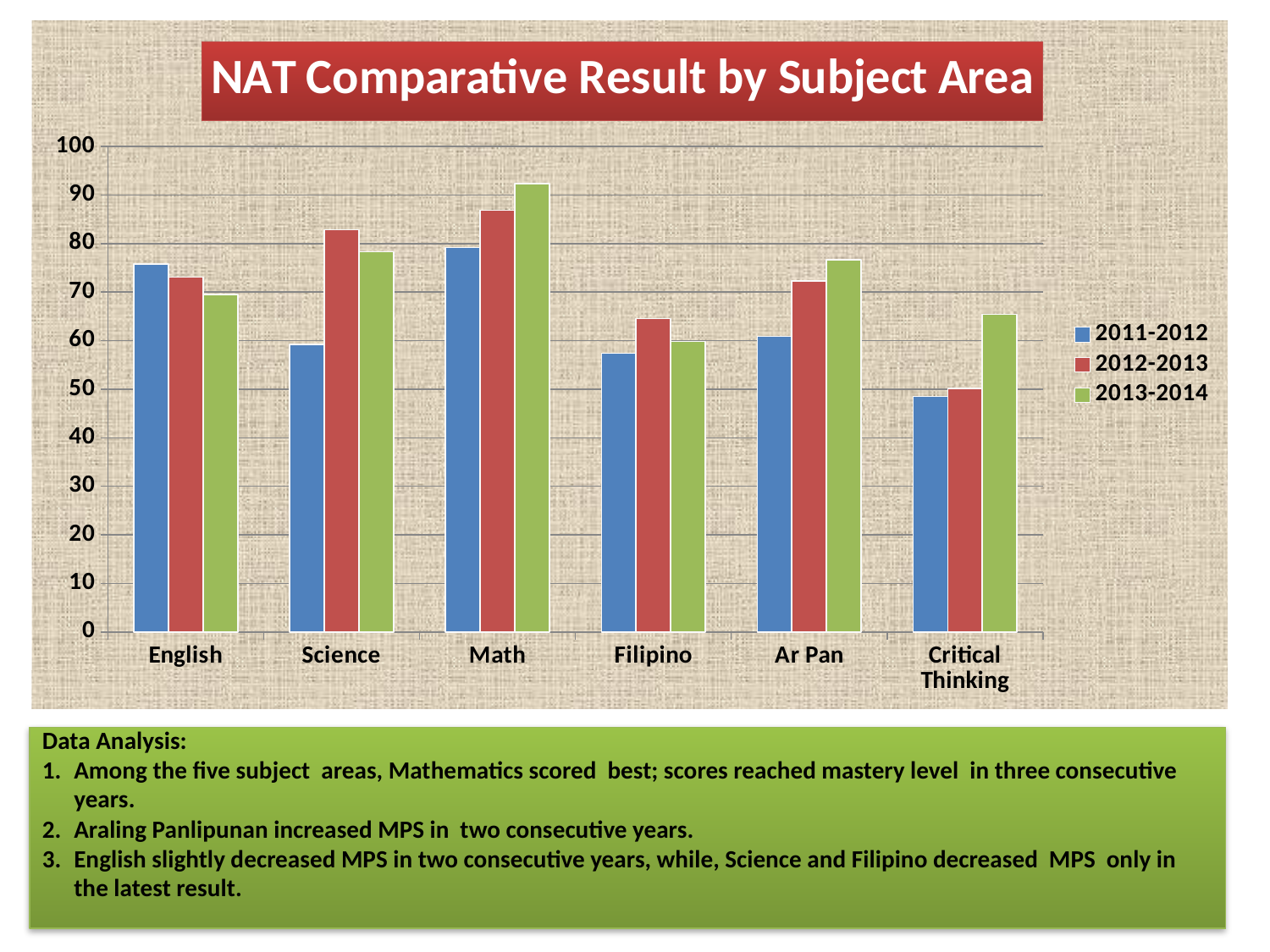
How many subject areas are shown on the x axis? 6 Which subject area has the lowest 2011-2012 bar? Critical Thinking Is the 2011-2012 value for Filipino greater or less than 60? less What kind of chart is shown on the slide? bar chart Is the 2012-2013 value for Science greater or less than 80? greater What is the title of the chart? NAT Comparative Result by Subject Area Do the English values rise or fall from 2011-2012 to 2013-2014? fall For Science, which is larger: the 2012-2013 value or the 2013-2014 value? 2012-2013 Which subject area has the highest 2013-2014 bar? Math Do the Ar Pan values rise or fall from 2011-2012 to 2013-2014? rise Is the 2013-2014 value for Math greater or less than 90? greater How many series does the legend list? 3